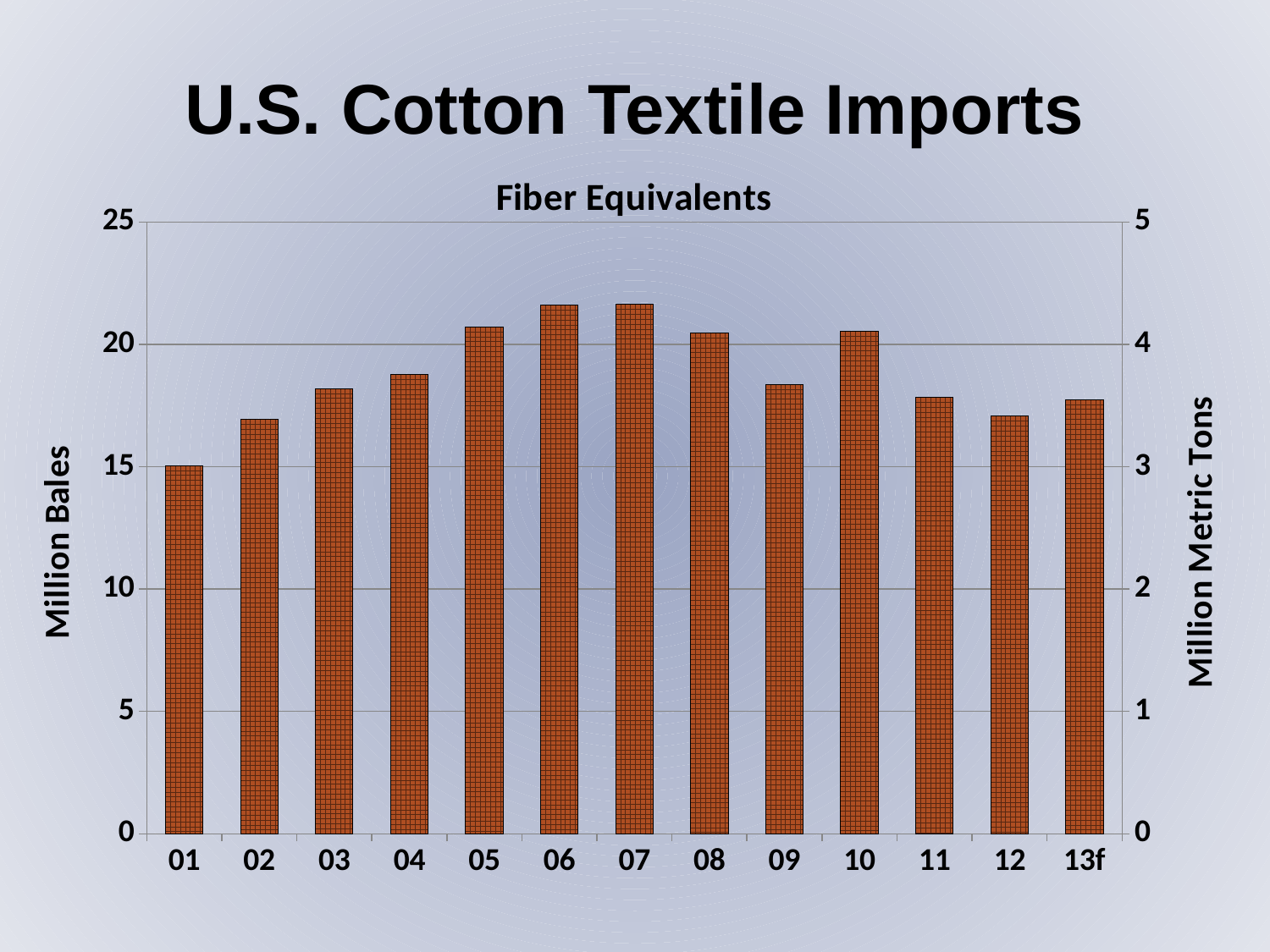
Is the value for 09 greater or less than 20 million bales? less Is the value for 12 greater or less than 20 million bales? less Is the value for 02 greater or less than 20 million bales? less Which year has the lowest value in the chart? 01 What is the label on the right-hand vertical axis? Million Metric Tons Which is larger, the value for 01 or the value for 12? 12 Do the values rise or fall from 01 to 07? rise How many bars (years) are plotted in the chart? 13 What kind of chart is shown on the slide? bar chart Which is larger, the value for 05 or the value for 02? 05